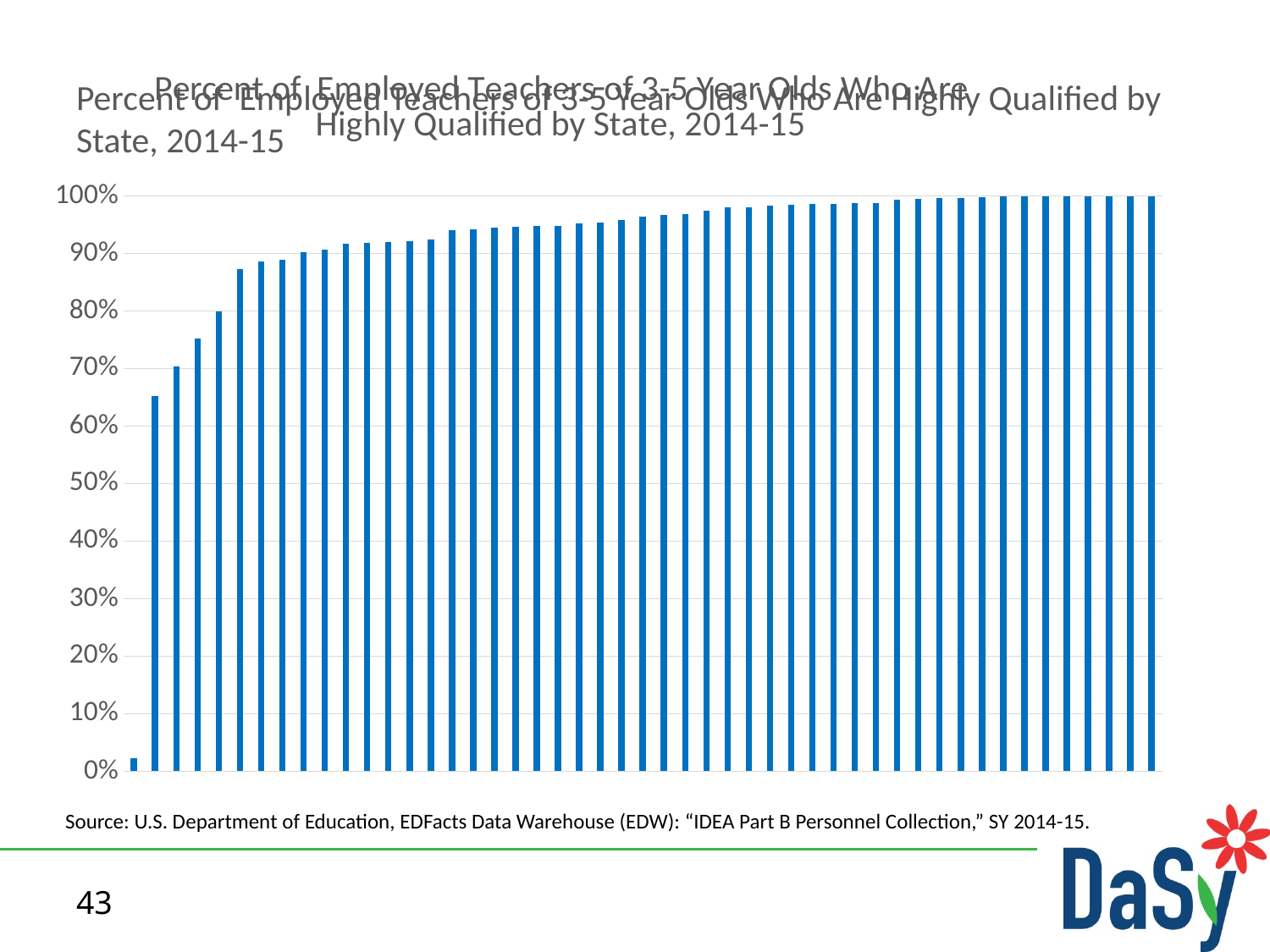
Is the value of the sixth bar from the left greater or less than 80%? greater Is the value of the fourth bar from the left greater or less than 70%? greater Is the value of the second bar from the left greater or less than the value of the rightmost bar? less Which bar has the lowest value in the chart? the leftmost bar What is the title of the chart? Percent of Employed Teachers of 3-5 Year Olds Who Are Highly Qualified by State, 2014-15 Do the bar values rise or fall from left to right across the chart? rise Is the value of the leftmost bar greater or less than 10%? less What kind of chart is shown on the slide? bar chart What is the highest value shown on the vertical axis? 100%